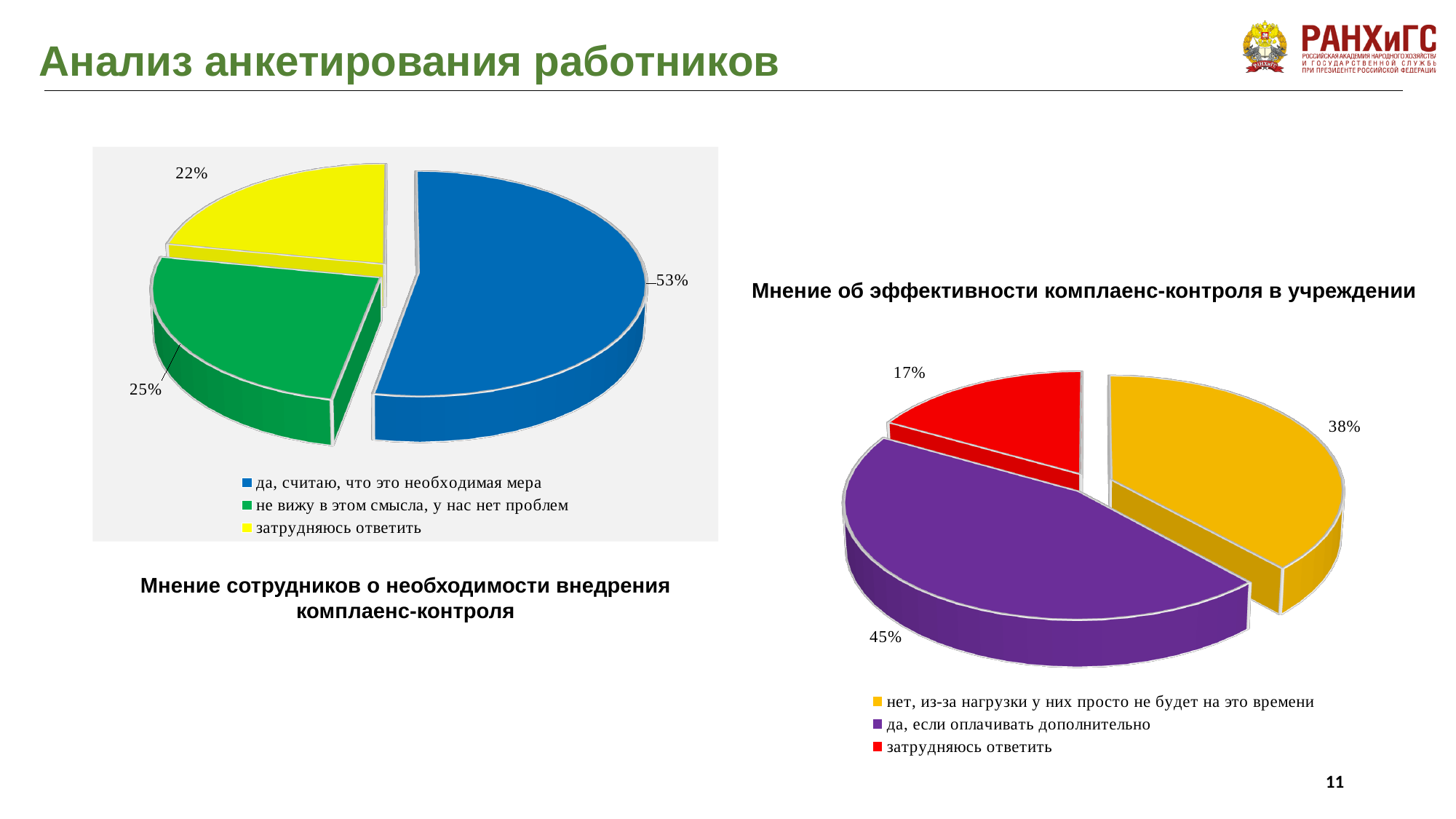
На диаграмме «Мнение сотрудников о необходимости внедрения комплаенс-контроля» какая доля приходится на ответ «да, считаю, что это необходимая мера»? 53% На диаграмме «Мнение об эффективности комплаенс-контроля в учреждении» какая доля приходится на ответ «затрудняюсь ответить»? 17% На диаграмме «Мнение об эффективности комплаенс-контроля в учреждении» на сколько процентных пунктов доля ответа «да, если оплачивать дополнительно» больше доли ответа «нет, из-за нагрузки у них просто не будет на это времени»? 7 На диаграмме «Мнение об эффективности комплаенс-контроля в учреждении» что больше: доля ответа «нет, из-за нагрузки у них просто не будет на это времени» или доля ответа «затрудняюсь ответить»? нет, из-за нагрузки у них просто не будет на это времени На диаграмме «Мнение об эффективности комплаенс-контроля в учреждении» какая доля приходится на ответ «да, если оплачивать дополнительно»? 45% На диаграмме «Мнение об эффективности комплаенс-контроля в учреждении» каким цветом показан ответ «затрудняюсь ответить»? красным На диаграмме «Мнение сотрудников о необходимости внедрения комплаенс-контроля» сколько вариантов ответа перечислено в легенде? 3 На диаграмме «Мнение сотрудников о необходимости внедрения комплаенс-контроля» на сколько процентных пунктов доля ответа «да, считаю, что это необходимая мера» больше доли ответа «затрудняюсь ответить»? 31 На диаграмме «Мнение сотрудников о необходимости внедрения комплаенс-контроля» какой вариант ответа имеет наименьшую долю? затрудняюсь ответить На диаграмме «Мнение сотрудников о необходимости внедрения комплаенс-контроля» какая доля приходится на ответ «не вижу в этом смысла, у нас нет проблем»? 25% На диаграмме «Мнение об эффективности комплаенс-контроля в учреждении» какой вариант ответа имеет наибольшую долю? да, если оплачивать дополнительно Какого типа диаграмма «Мнение сотрудников о необходимости внедрения комплаенс-контроля»? круговая диаграмма